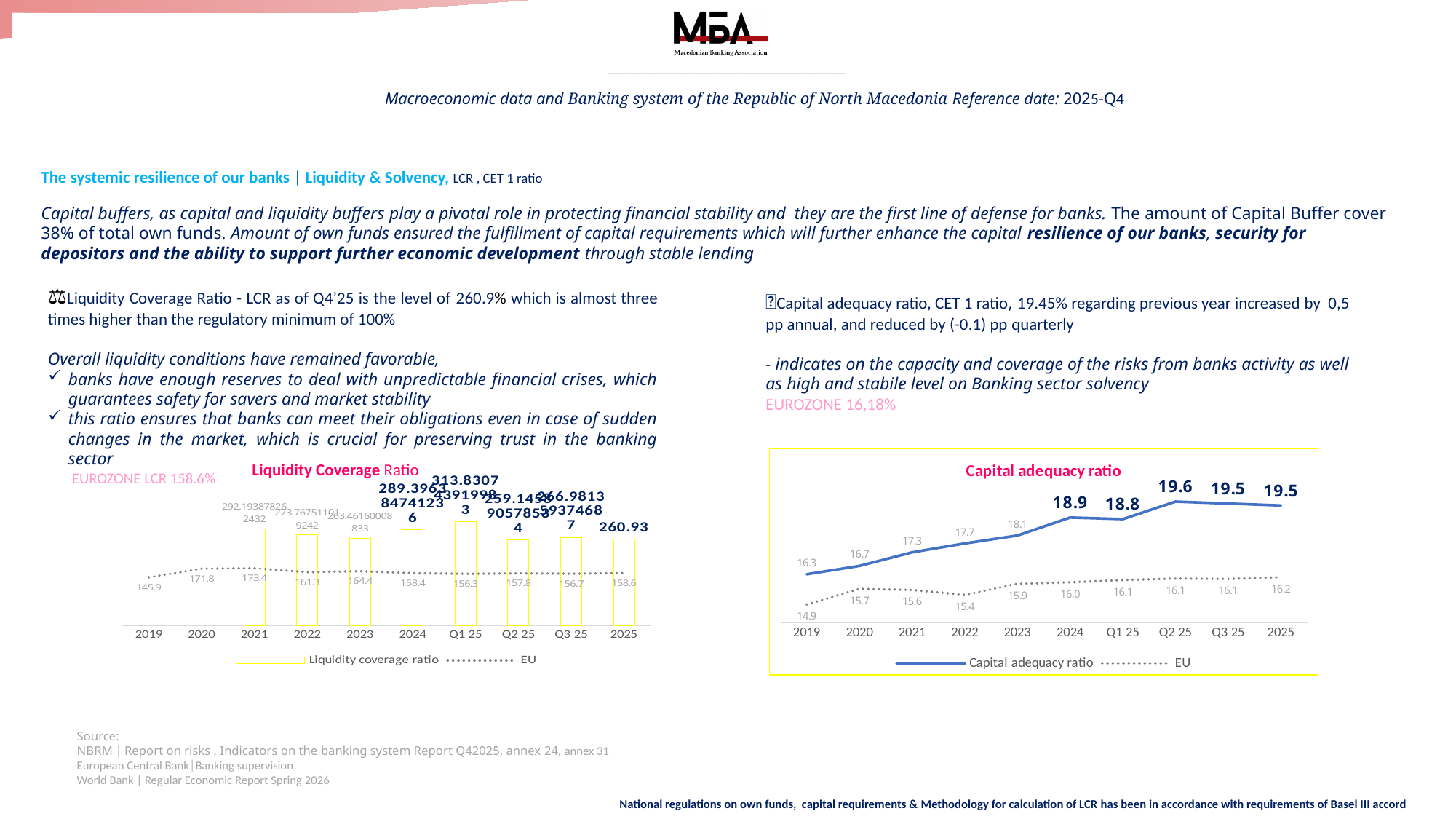
In the Capital adequacy ratio chart, what is the difference between the Capital adequacy ratio and the EU value for 2025? 3.3 In the Capital adequacy ratio chart, which category has the highest Capital adequacy ratio value? Q2 25 In the Liquidity Coverage Ratio chart, what is the EU value for 2019? 145.9 In the Capital adequacy ratio chart, what is the EU value for 2019? 14.9 How many series does the legend of the Capital adequacy ratio chart list? 2 In the Capital adequacy ratio chart, does the Capital adequacy ratio line generally rise or fall from 2019 to 2025? rise In the Liquidity Coverage Ratio chart, which category has the highest EU value? 2021 What type of chart is the Capital adequacy ratio chart? line chart In the Liquidity Coverage Ratio chart, what is the Liquidity coverage ratio value for 2025? 260.93 How many categories are shown on the x axis of the Liquidity Coverage Ratio chart? 10 In the Capital adequacy ratio chart, which category has the lowest EU value? 2019 In the Capital adequacy ratio chart, what is the Capital adequacy ratio value for 2024? 18.9